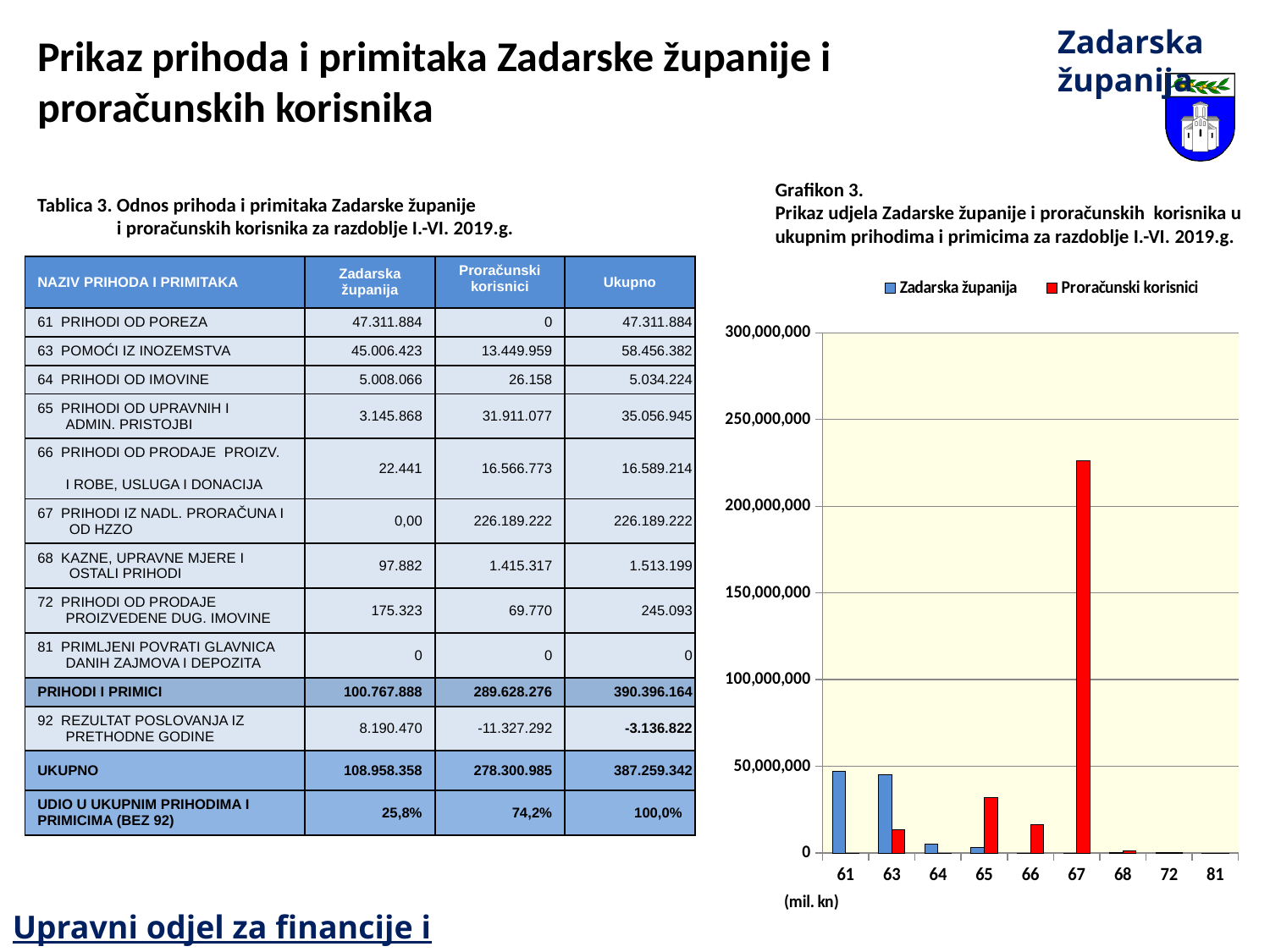
In Grafikon 3, is the Zadarska županija value for category 63 greater or less than 50,000,000? less How many categories are shown on the x axis of Grafikon 3? 9 In Grafikon 3, is the Proračunski korisnici value for category 67 greater or less than 200,000,000? greater What unit is shown below the x axis of Grafikon 3? (mil. kn) In Grafikon 3, which category has the tallest bar for Proračunski korisnici? 67 In Grafikon 3, for category 65, which series has the larger value: Zadarska županija or Proračunski korisnici? Proračunski korisnici How many series does the legend of Grafikon 3 list? 2 In Grafikon 3, which colour represents the Proračunski korisnici series? red In Grafikon 3, is the Proračunski korisnici value for category 65 greater or less than 50,000,000? less What kind of chart is Grafikon 3? bar chart In Grafikon 3, for category 63, which series has the larger value: Zadarska županija or Proračunski korisnici? Zadarska županija